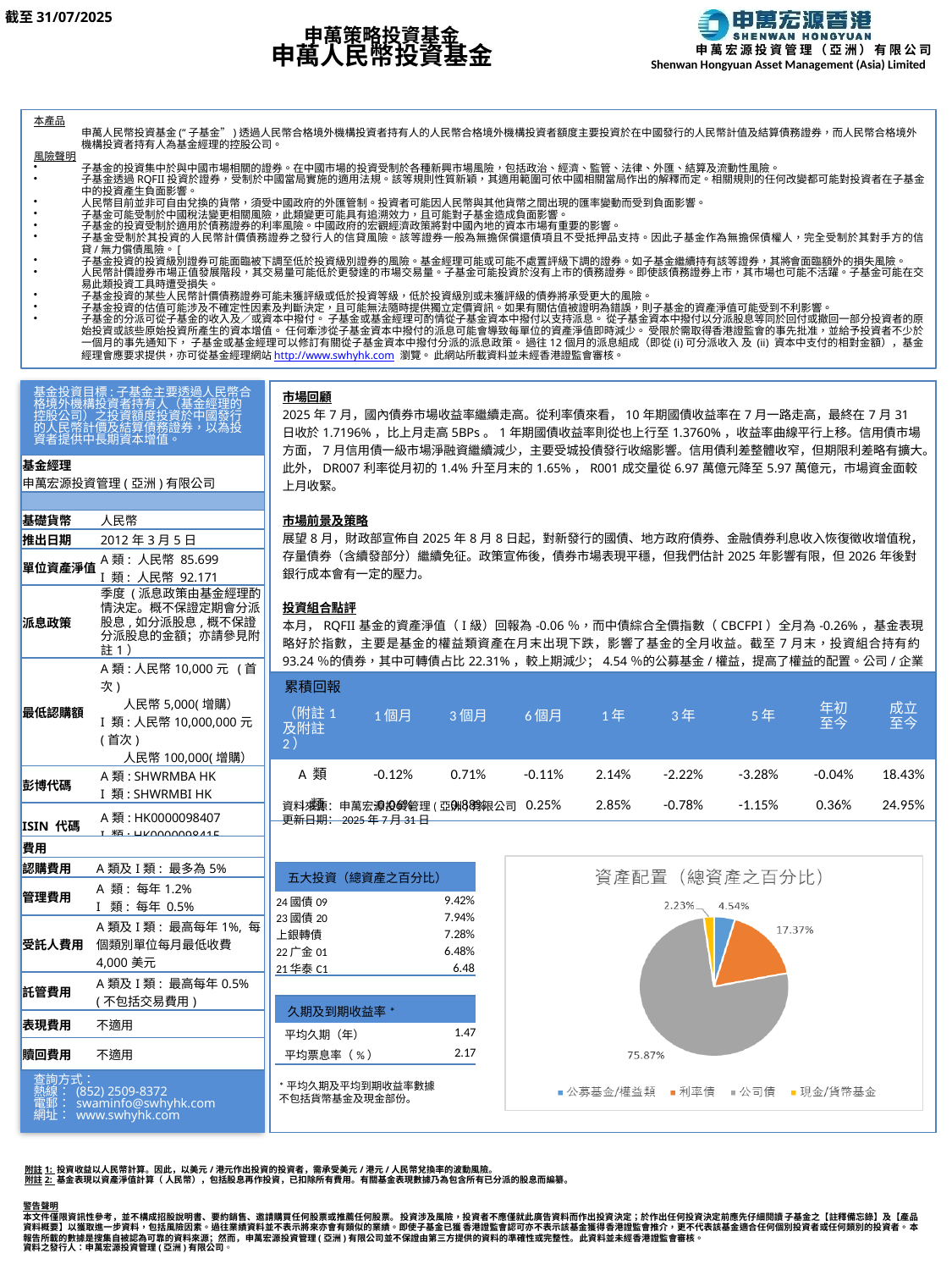
What colour is the 公司債 slice in the 資產配置（總資產之百分比） pie chart? grey In the 資產配置（總資產之百分比） pie chart, which is larger: 利率債 or 公司債? 公司債 How many slices does the 資產配置（總資產之百分比） pie chart have? 4 What percentage is shown for 利率債 in the 資產配置（總資產之百分比） pie chart? 17.37% What is the smallest percentage label shown in the 資產配置（總資產之百分比） pie chart? 2.23% What percentage is shown for 公司債 in the 資產配置（總資產之百分比） pie chart? 75.87% In the 資產配置（總資產之百分比） pie chart, what is the difference between the 公司債 share and the 利率債 share? 58.50% In the 資產配置（總資產之百分比） pie chart, what is the combined share of 公司債 and 利率債? 93.24% Which category has the largest slice in the 資產配置（總資產之百分比） pie chart? 公司債 How many entries does the legend of the 資產配置（總資產之百分比） chart list? 4 What kind of chart is the 資產配置（總資產之百分比） chart? pie chart What is the title of the pie chart on the slide? 資產配置（總資產之百分比）